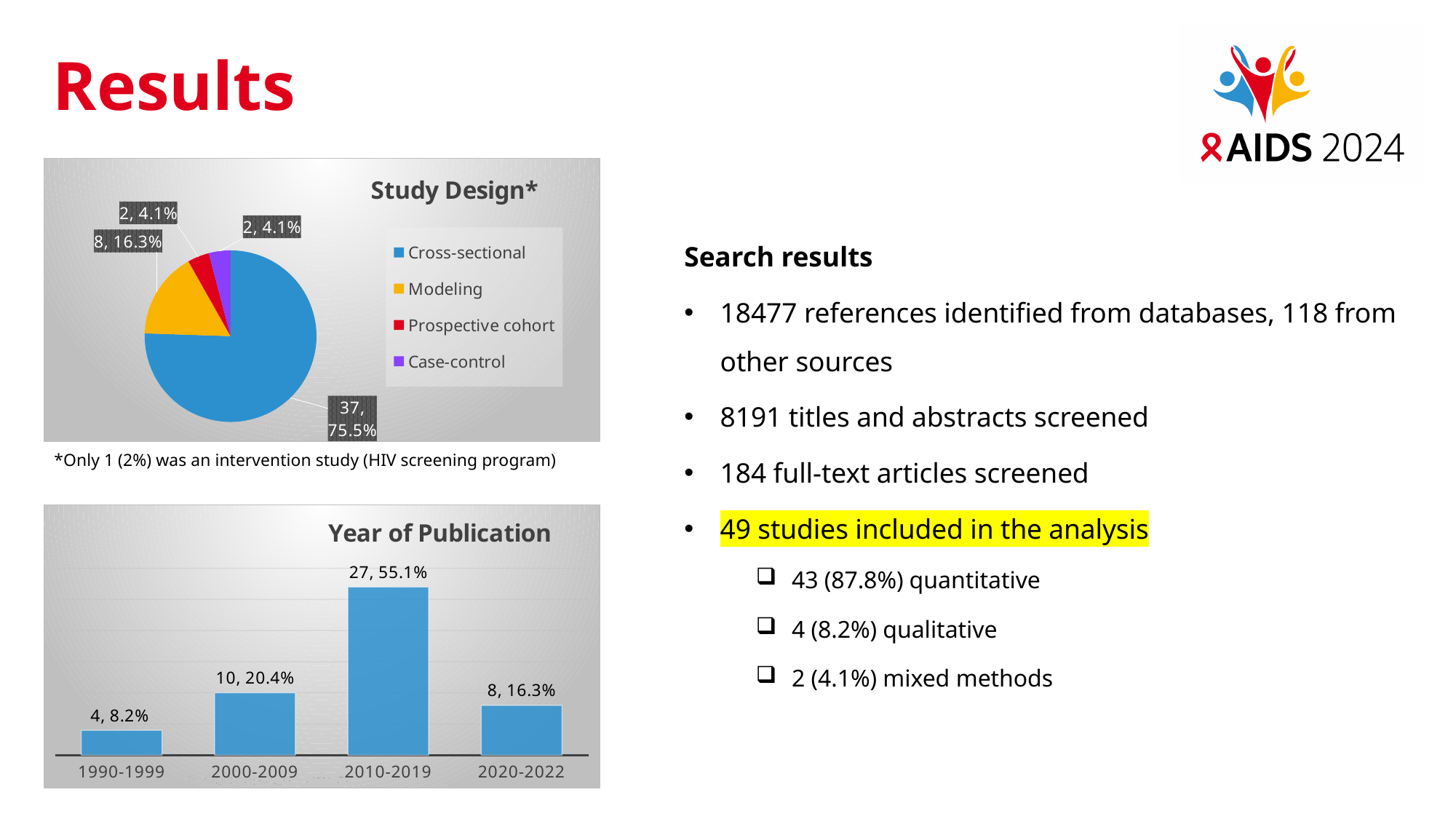
In the Study Design chart, what share of the pie does Modeling represent? 16.3% In the Year of Publication chart, which has more publications, 2000-2009 or 2020-2022? 2000-2009 In the Study Design chart, what is the value and share for Cross-sectional? 37, 75.5% In the Year of Publication chart, what is the difference in number of publications between 2010-2019 and 2000-2009? 17 In the Year of Publication chart, what kind of chart is shown? bar chart In the Study Design chart, how many categories does the legend list? 4 In the Year of Publication chart, which period has the lowest number of publications? 1990-1999 In the Year of Publication chart, what is the value for 2010-2019? 27, 55.1% In the Year of Publication chart, how many periods are shown on the x axis? 4 In the Study Design chart, how many studies are Prospective cohort? 2 In the Study Design chart, what kind of chart is shown? pie chart In the Study Design chart, which study design has the largest slice? Cross-sectional